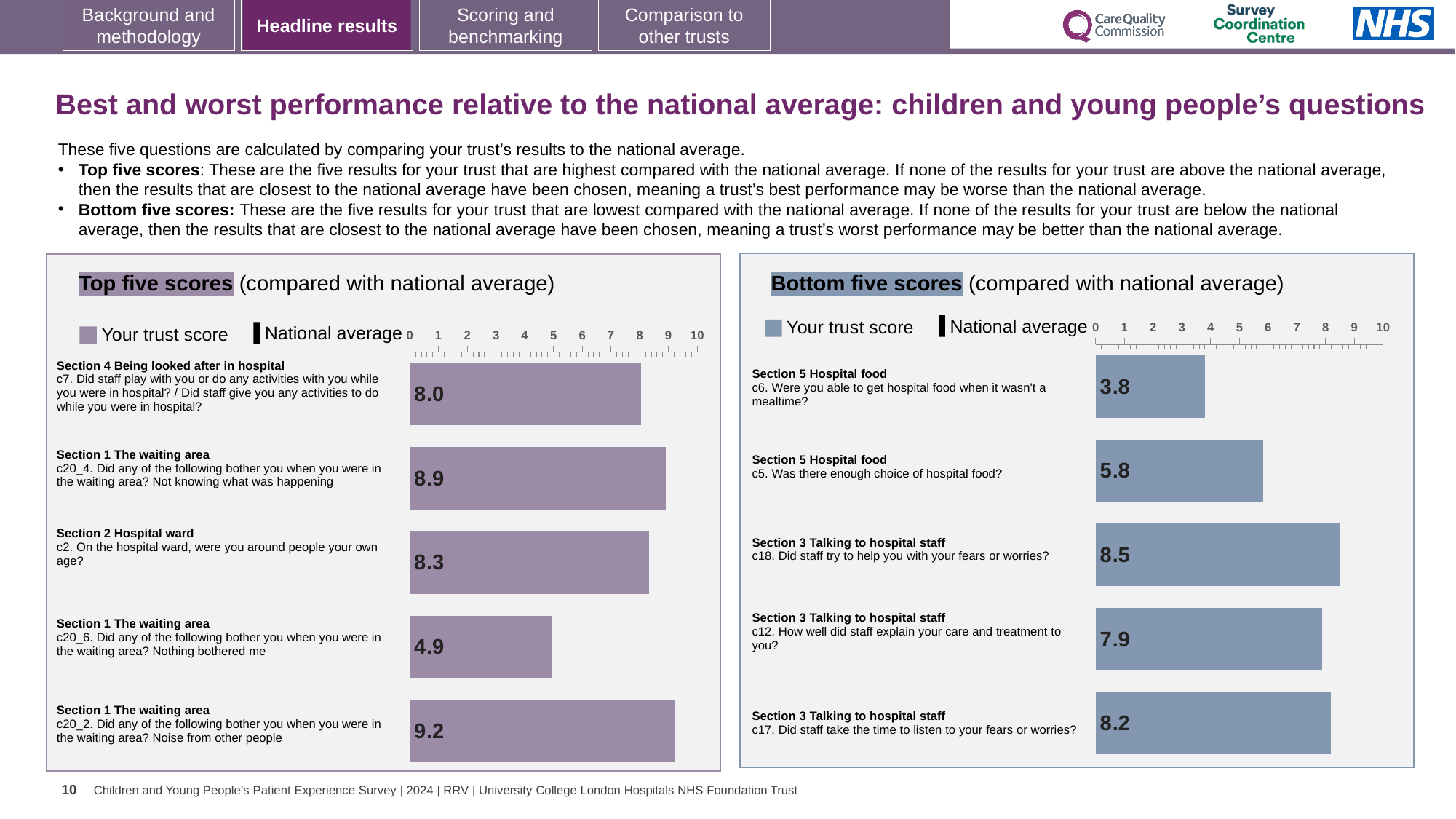
In the Top five scores chart, what is the trust score for c20_2 (Noise from other people)? 9.2 In the Bottom five scores chart, which question has the highest trust score? c18. Did staff try to help you with your fears or worries? In the Top five scores chart, which question has the highest trust score? c20_2. Noise from other people In the Top five scores chart, what is the difference between the trust scores for c20_4 (Not knowing what was happening) and c2 (On the hospital ward, were you around people your own age?)? 0.6 In the Top five scores chart, what is the trust score for c7 (Did staff play with you or do any activities with you while you were in hospital?)? 8.0 What kind of chart is used in the Top five scores panel? Bar chart In the Bottom five scores chart, what is the trust score for c6 (Were you able to get hospital food when it wasn't a mealtime?)? 3.8 In the Bottom five scores chart, which has the larger trust score: c17 (Did staff take the time to listen to your fears or worries?) or c12 (How well did staff explain your care and treatment to you?)? c17 In the Bottom five scores chart, what is the difference between the trust scores for c5 (Was there enough choice of hospital food?) and c6 (Were you able to get hospital food when it wasn't a mealtime?)? 2.0 In the Top five scores chart, which question has the lowest trust score? c20_6. Nothing bothered me In the Bottom five scores chart, what is the trust score for c12 (How well did staff explain your care and treatment to you?)? 7.9 In the Bottom five scores chart, which question has the lowest trust score? c6. Were you able to get hospital food when it wasn't a mealtime?